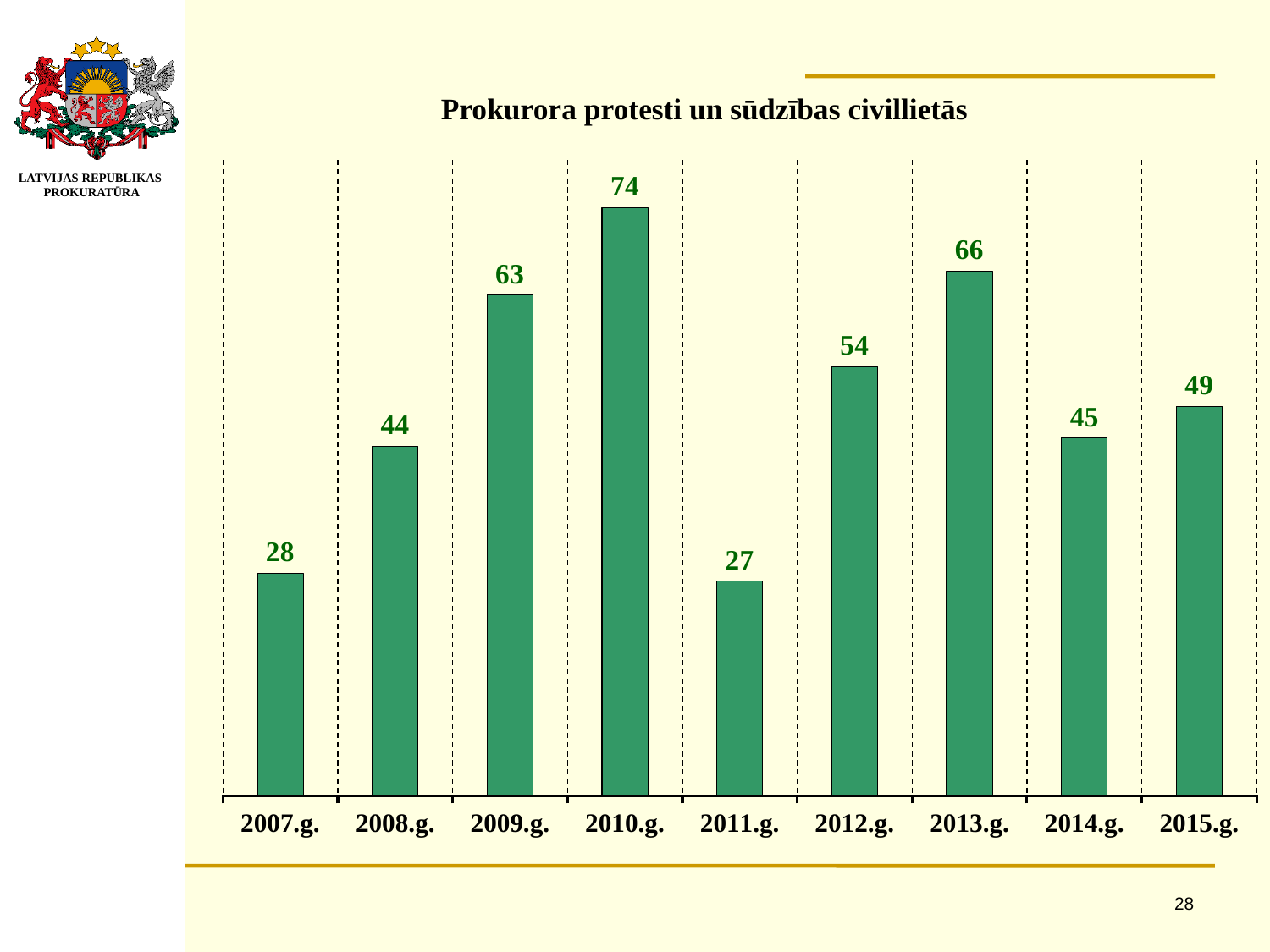
Which year has the lowest value? 2011.g. What is the value for 2010.g.? 74 What is the value for 2007.g.? 28 Which is larger, the value for 2012.g. or the value for 2015.g.? 2012.g. What is the difference between the values for 2010.g. and 2011.g.? 47 How many years are shown on the x axis? 9 What is the difference between the values for 2009.g. and 2008.g.? 19 Do the values rise or fall from 2007.g. to 2010.g.? rise Which year has the highest value? 2010.g. What is the title of the chart? Prokurora protesti un sūdzības civillietās What kind of chart is shown on the slide? bar chart What is the value for 2013.g.? 66